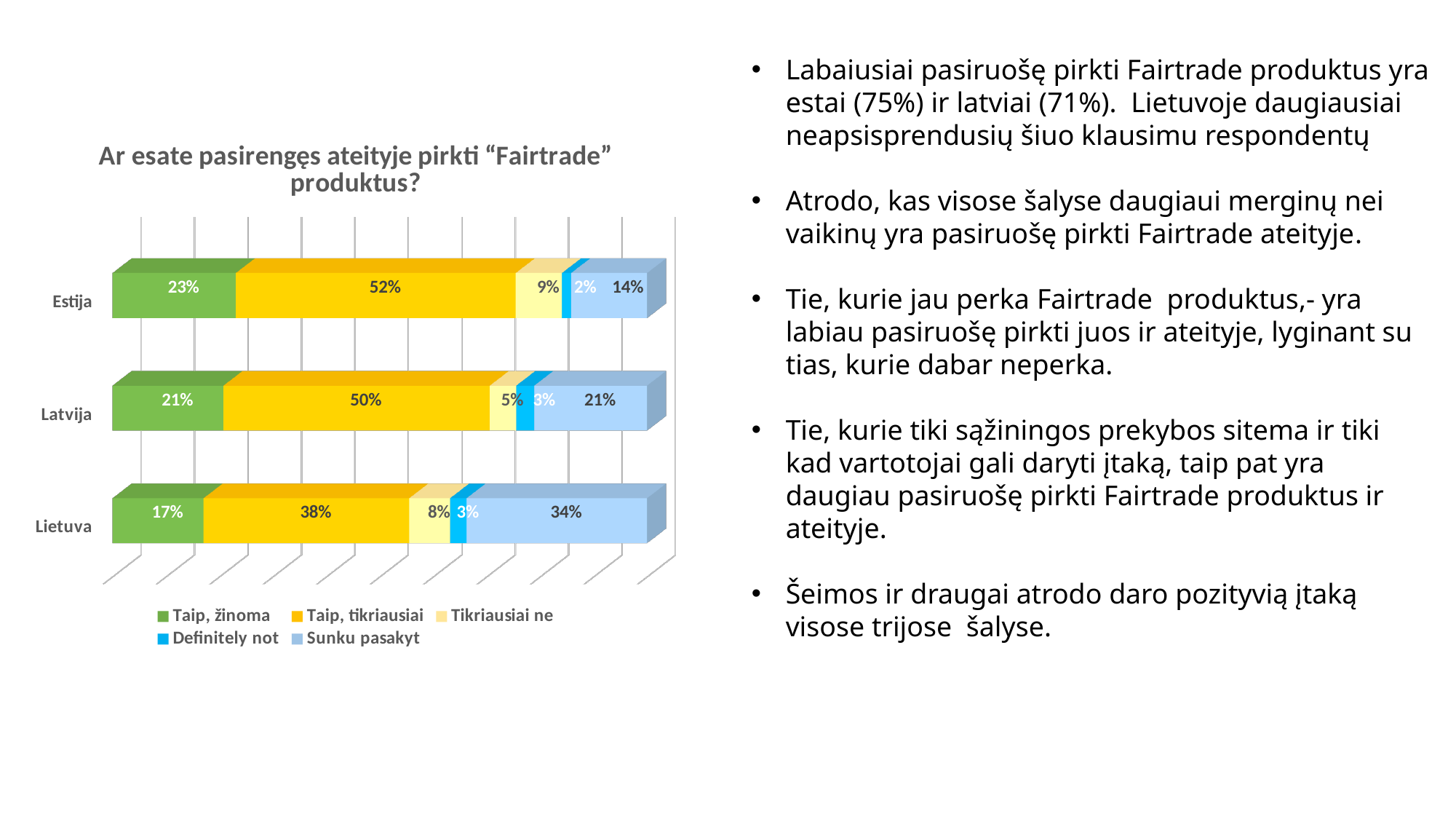
What kind of chart is shown on the slide? Stacked bar chart How many series does the legend list? 5 Which is larger: the "Sunku pasakyt" value for Latvija or for Estija? Latvija What percentage of respondents in Estija answered "Taip, žinoma"? 23% Which country has the highest "Sunku pasakyt" share? Lietuva Which country has the lowest "Taip, žinoma" share? Lietuva How many countries are shown in the chart? 3 What is the "Taip, tikriausiai" value for Latvija? 50% What is the "Tikriausiai ne" value for Estija? 9% What is the combined share of "Taip, žinoma" and "Taip, tikriausiai" for Latvija? 71% What is the difference between the "Taip, tikriausiai" values for Estija and Lietuva? 14% What is the "Sunku pasakyt" value for Lietuva? 34%